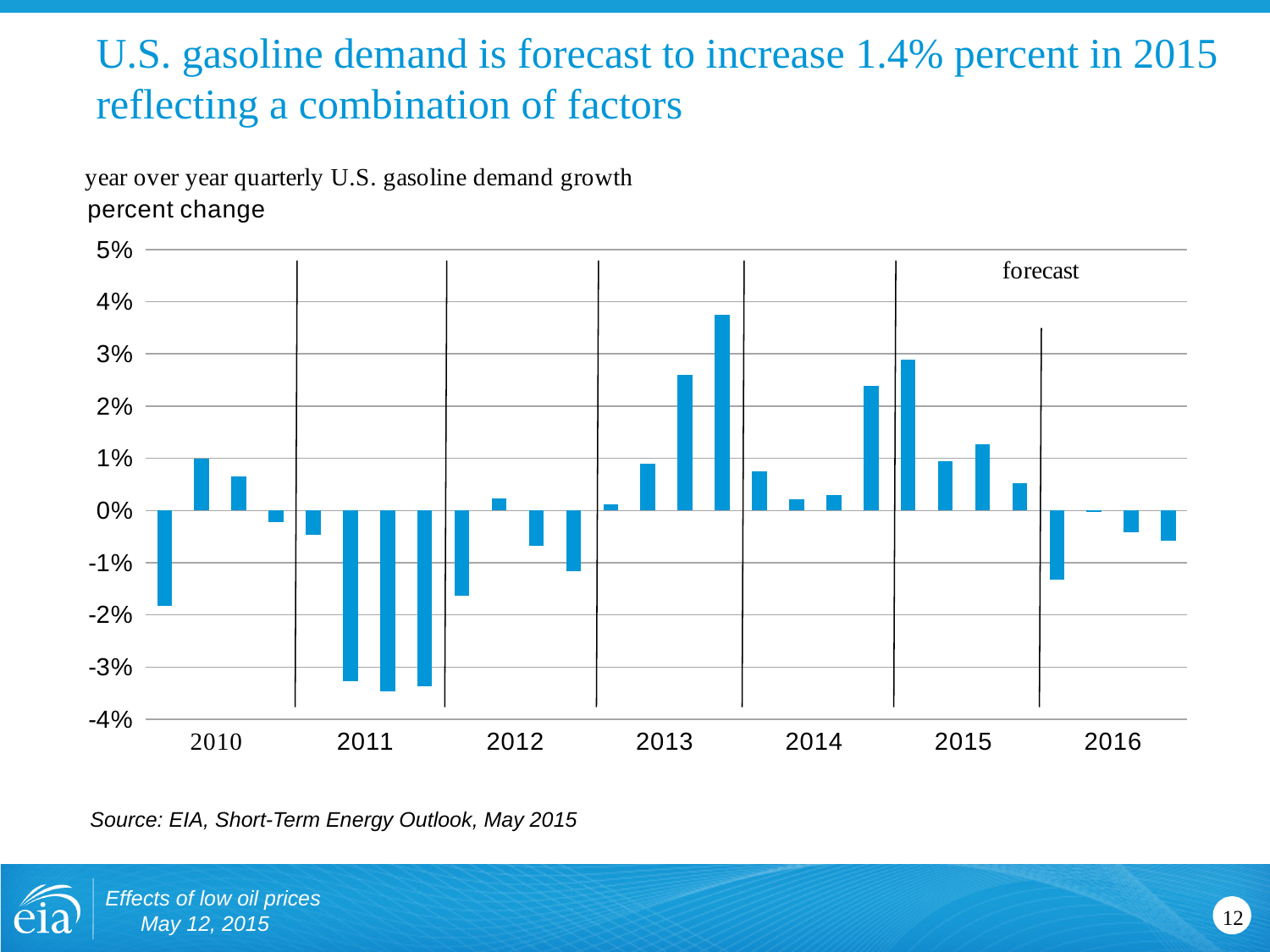
What kind of chart is shown on the slide? bar chart Which is larger, the first bar in 2015 or the first bar in 2014? the first bar in 2015 Is the value of the first bar in 2010 greater or less than -1%? less Is the value of the lowest bar in 2011 greater or less than -3%? less In which year do the lowest (most negative) bars appear? 2011 What label appears in the upper right of the chart area to mark the projected period? forecast In which year does the tallest (highest positive) bar appear? 2013 What is the unit label shown above the y axis of the chart? percent change Is the value of the first bar in 2015 greater or less than 2%? greater How many years are labeled on the x axis? 7 Do the quarterly bars within 2013 rise or fall from left to right? rise